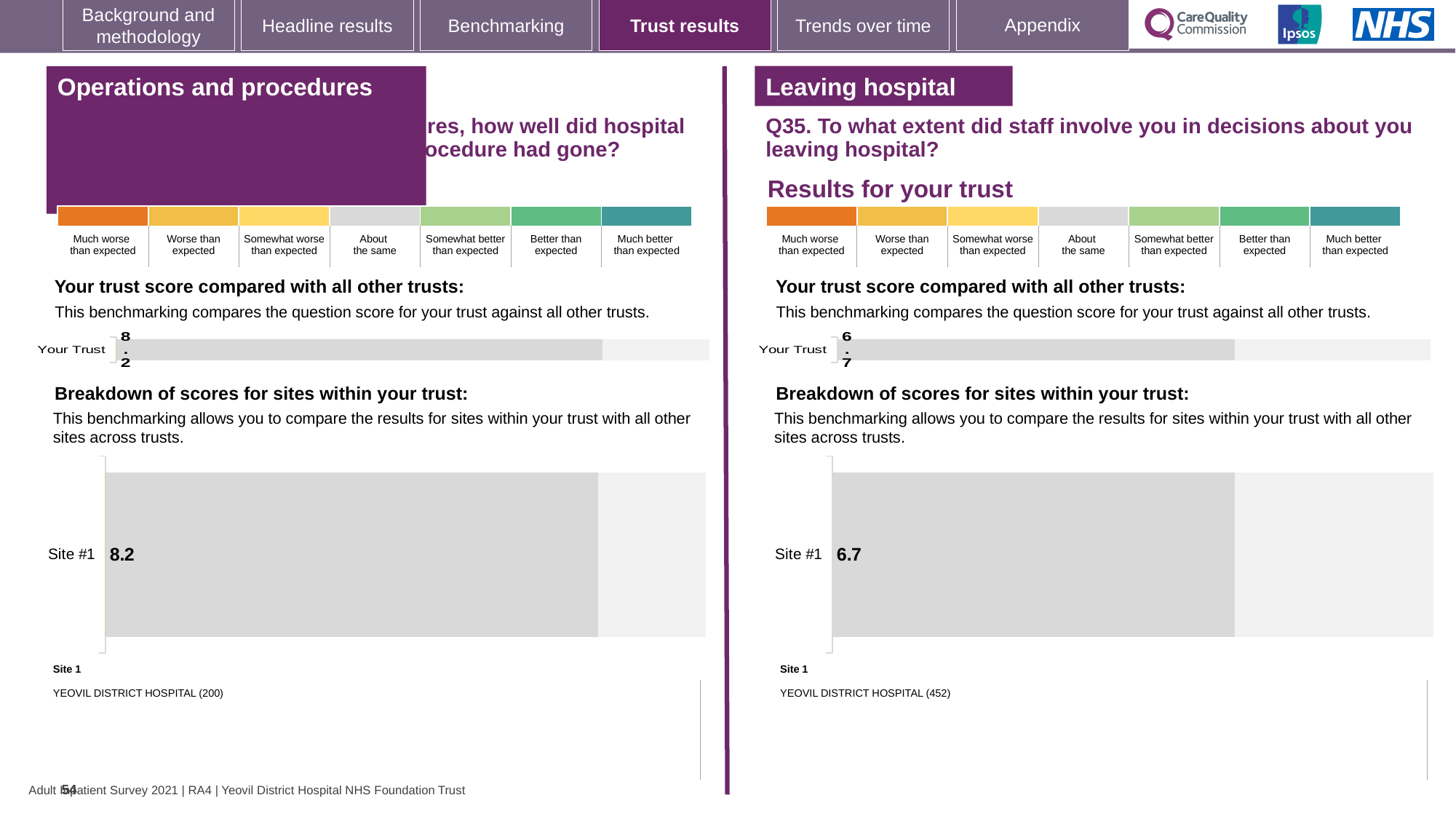
How many sites are shown in the breakdown of scores chart in the right-hand 'Leaving hospital' section? 1 On the right-hand 'Leaving hospital' section, what is the value shown for 'Your Trust' in the trust score chart? 6.7 Is the 'Your Trust' score in the left-hand 'Operations and procedures' chart greater or less than the 'Your Trust' score in the right-hand 'Leaving hospital' chart? greater In the right-hand 'Leaving hospital' section, which site name is listed as Site 1 below the chart? YEOVIL DISTRICT HOSPITAL (452) How many sites are shown in the breakdown of scores chart in the left-hand 'Operations and procedures' section? 1 In the left-hand 'Operations and procedures' section, which site name is listed as Site 1 below the chart? YEOVIL DISTRICT HOSPITAL (200) On the left-hand 'Operations and procedures' section, what is the score shown for Site #1 in the breakdown of scores chart? 8.2 On the right-hand 'Leaving hospital' section, what is the score shown for Site #1 in the breakdown of scores chart? 6.7 What is the difference between the Site #1 score in the left-hand 'Operations and procedures' chart and the Site #1 score in the right-hand 'Leaving hospital' chart? 1.5 Which Site #1 score is larger: the one in the left-hand 'Operations and procedures' chart or the one in the right-hand 'Leaving hospital' chart? Operations and procedures (8.2) On the left-hand 'Operations and procedures' section, what is the value shown for 'Your Trust' in the trust score chart? 8.2 What type of chart is used to show the Site #1 score in the right-hand 'Leaving hospital' section? Bar chart